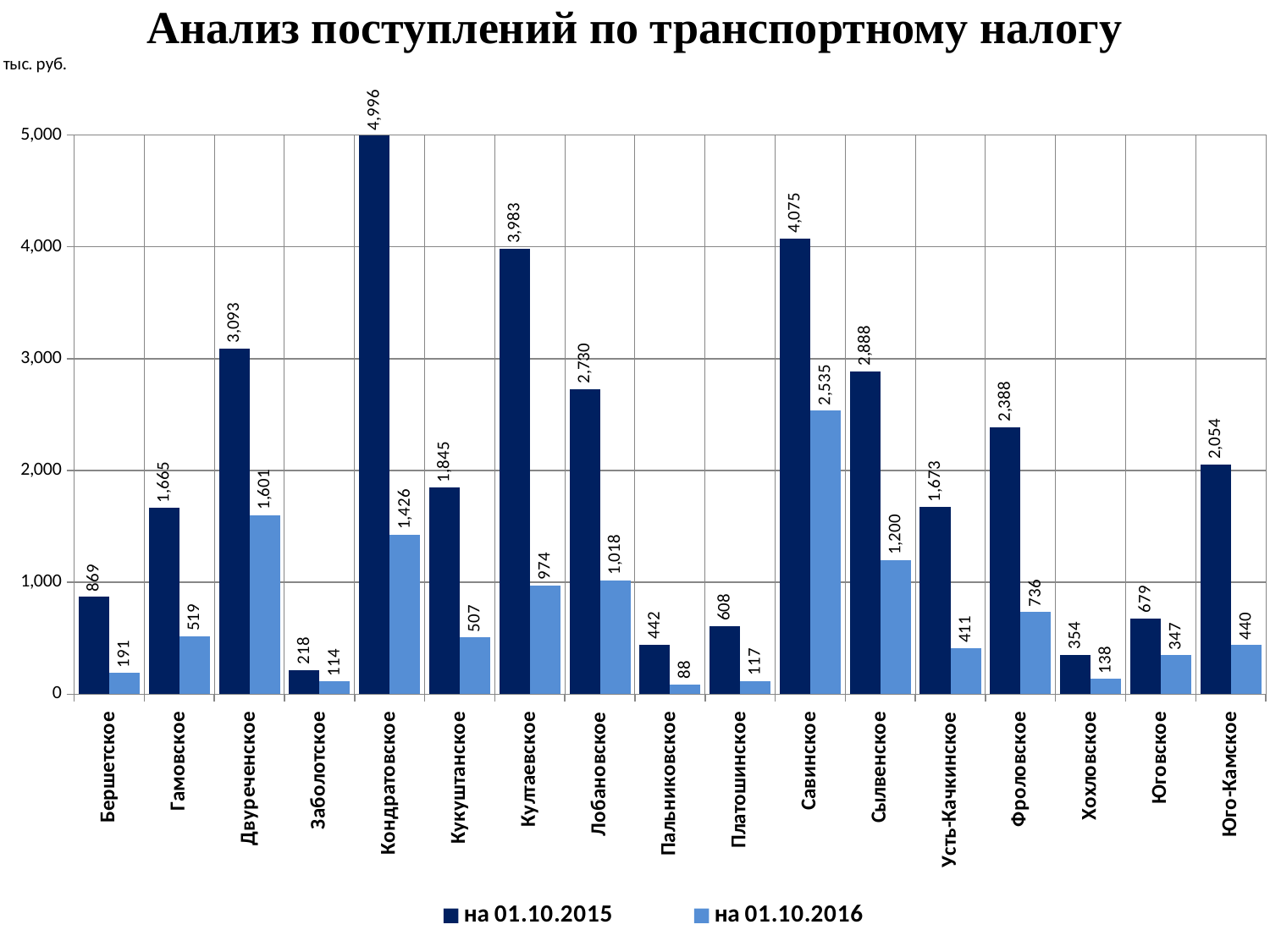
Which category has the highest value in the series на 01.10.2016? Савинское Which is larger for Двуреченское: the value на 01.10.2015 or на 01.10.2016? на 01.10.2015 What is the value for Кондратовское in the series на 01.10.2015? 4,996 What is the value for Пальниковское in the series на 01.10.2016? 88 What is the value for Савинское in the series на 01.10.2016? 2,535 How many series does the legend list? 2 What unit is indicated at the top left of the chart? тыс. руб. Which category has the lowest value in the series на 01.10.2015? Заболотское Which category has the highest value in the series на 01.10.2015? Кондратовское What is the difference between the на 01.10.2015 and на 01.10.2016 values for Кондратовское? 3,570 What kind of chart is shown on the slide? Bar chart How many categories are shown on the x axis? 17